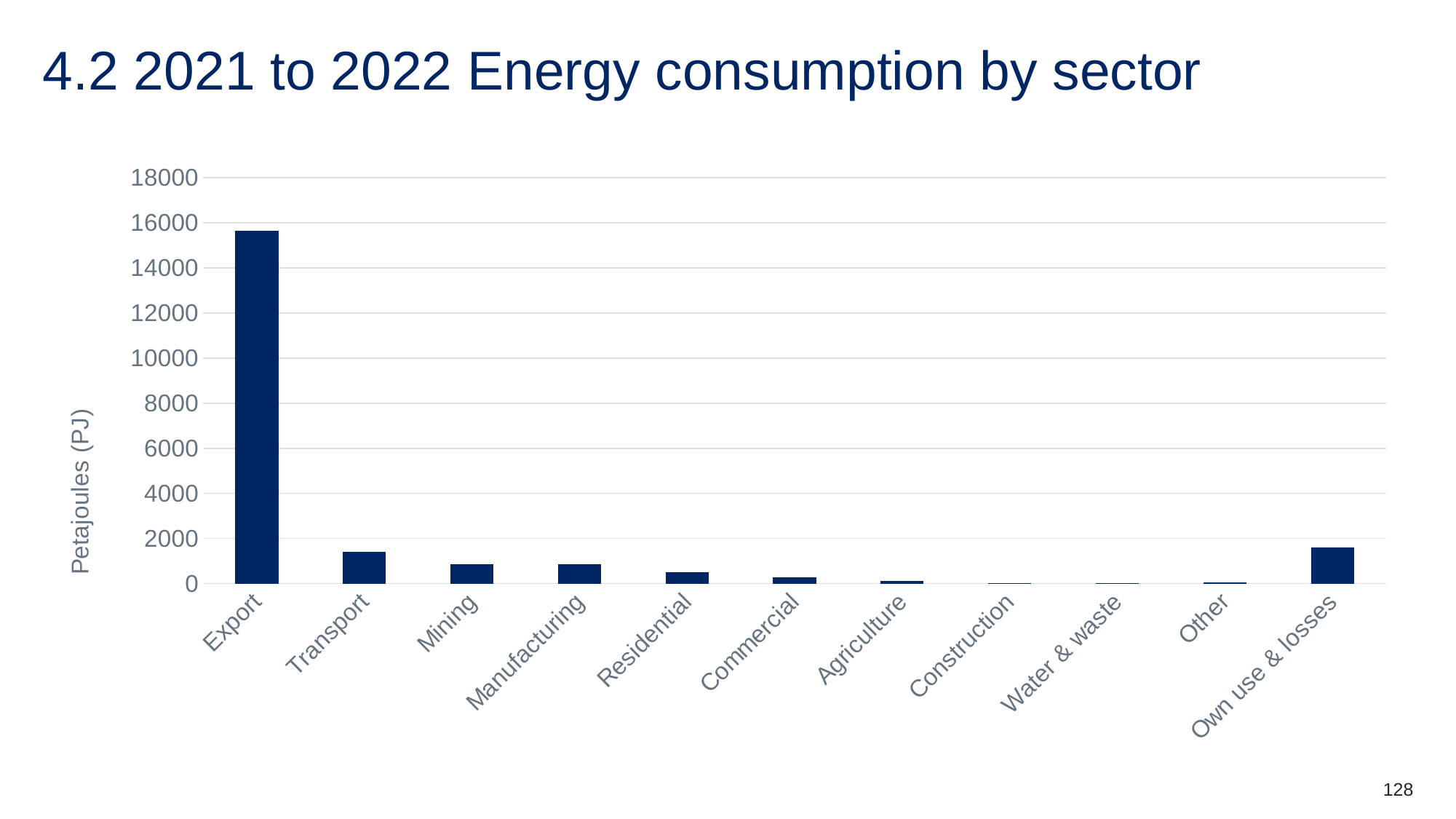
Is the value for Export greater or less than 14000? greater How many sectors are shown on the x axis? 11 Which is larger, the value for Export or the value for Transport? Export Is the value for Mining greater or less than 2000? less What is the label on the y axis? Petajoules (PJ) Is the value for Transport greater or less than 2000? less What is the title of the slide? 4.2 2021 to 2022 Energy consumption by sector Which is larger, the value for Transport or the value for Residential? Transport Which is larger, the value for Own use & losses or the value for Mining? Own use & losses Which sector has the highest energy consumption? Export What kind of chart is shown on the slide? bar chart